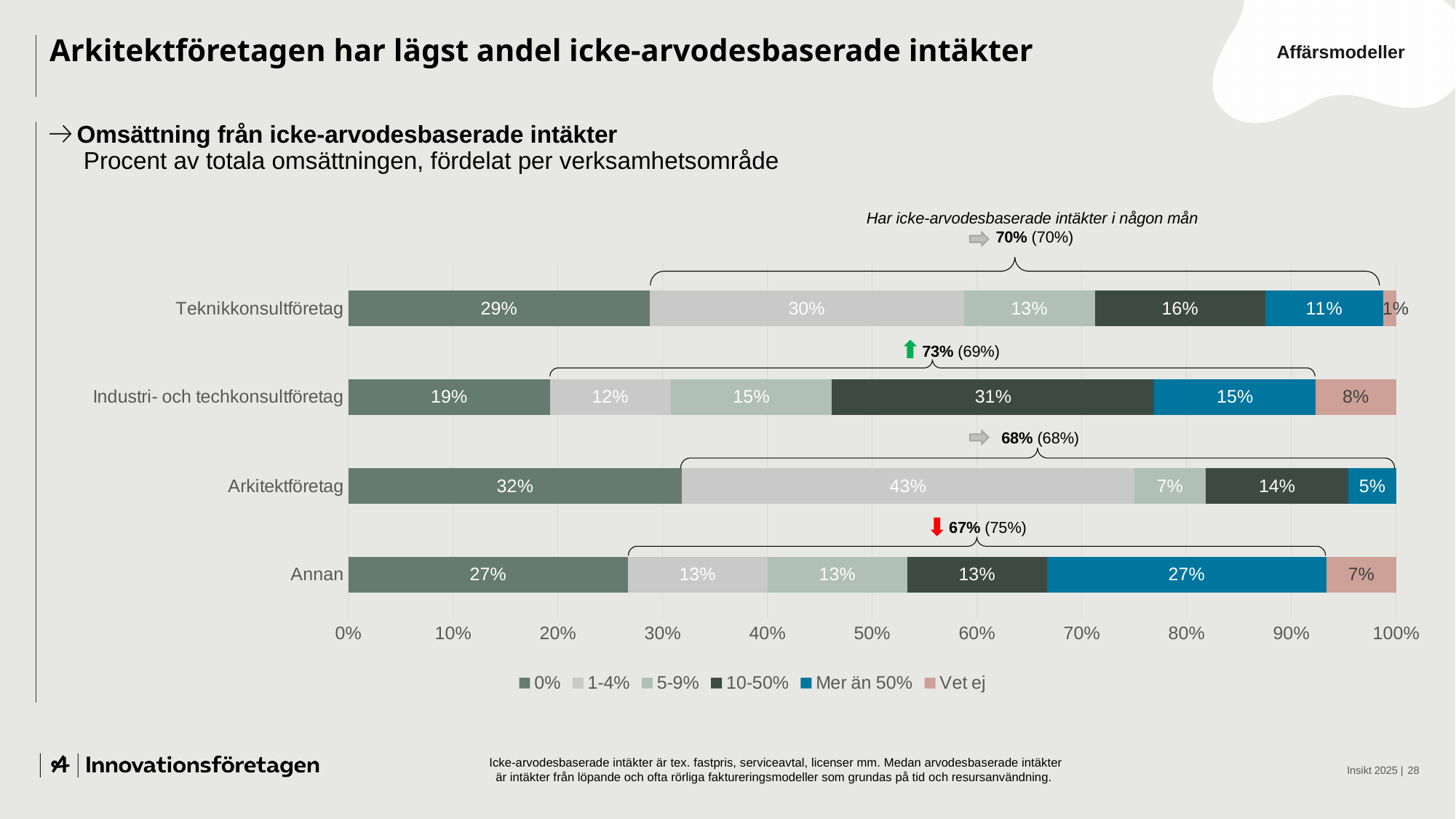
Which category has the smallest 'Mer än 50%' segment? Arkitektföretag What is the difference between the '1-4%' segment for Arkitektföretag and for Teknikkonsultföretag? 13% What is the value of the 'Vet ej' segment for Teknikkonsultföretag? 1% What is the value of the 'Mer än 50%' segment for Annan? 27% Which is larger: the '5-9%' segment for Industri- och techkonsultföretag or for Annan? Industri- och techkonsultföretag What kind of chart is shown on the slide? Stacked bar chart What is the value of the '10-50%' segment for Industri- och techkonsultföretag? 31% Which category has the largest '1-4%' segment? Arkitektföretag What share of Annan is annotated as having non-fee-based income to some extent ('Har icke-arvodesbaserade intäkter i någon mån')? 67% What is the value of the '0%' segment for Arkitektföretag? 32% How many series does the legend list? 6 How many categories (verksamhetsområden) are plotted on the chart? 4